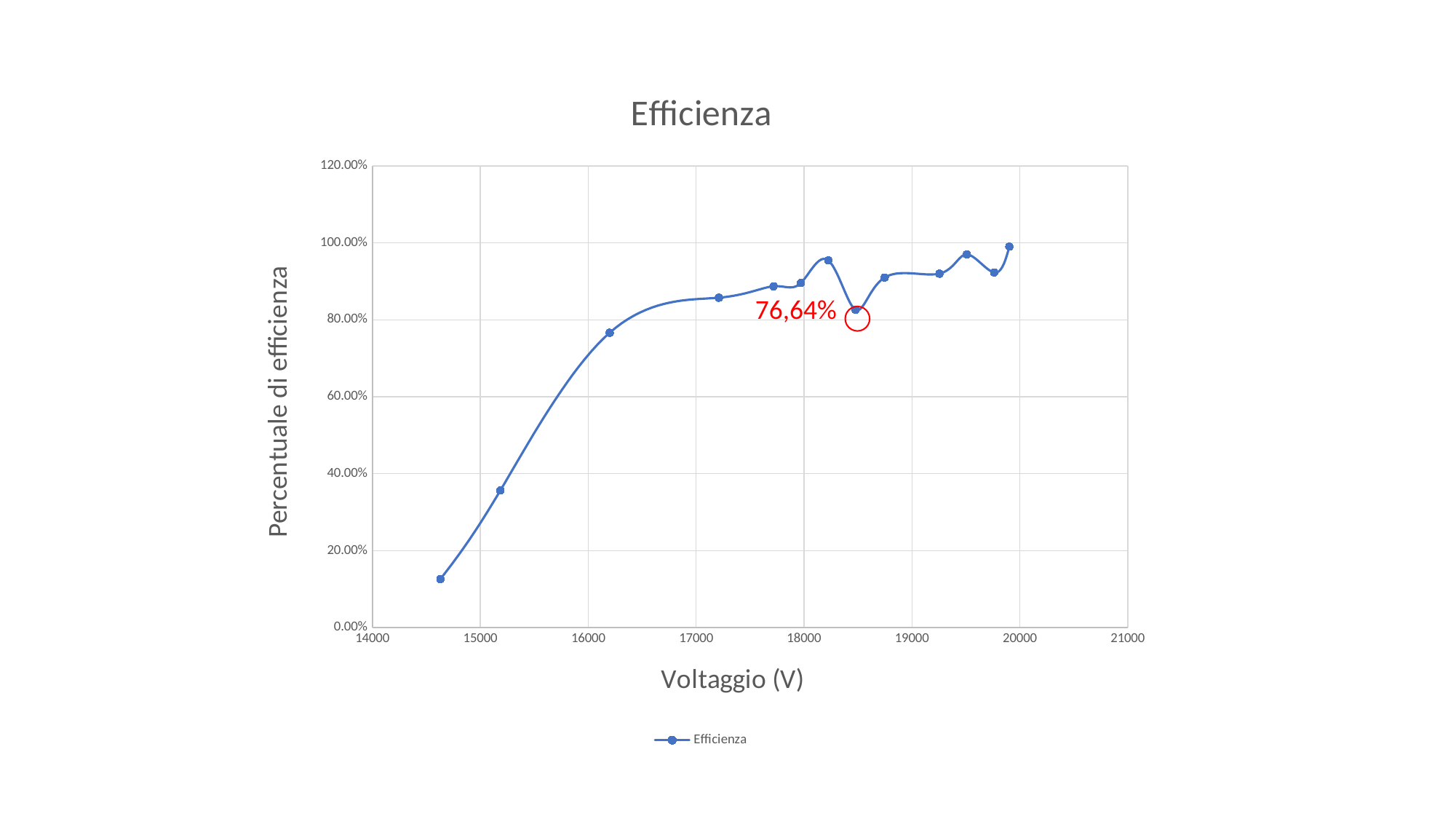
Overall, do the efficiency values rise or fall as the voltage increases along the x axis? rise How many data points are plotted on the chart? 13 How many series does the legend list? 1 What is the label of the x axis? Voltaggio (V) Is the efficiency value at the lowest voltage (around 14600 V) greater or less than 20.00%? less What is the title of the chart? Efficienza Is the efficiency value at about 15200 V greater or less than 40.00%? less Which point has the lowest efficiency: the one at about 14600 V or the one at about 15200 V? the one at about 14600 V What kind of chart is shown on the slide? line chart Is the efficiency value at about 17200 V greater or less than 80.00%? greater Which is larger: the efficiency at about 16200 V or the efficiency at about 15200 V? the efficiency at about 16200 V